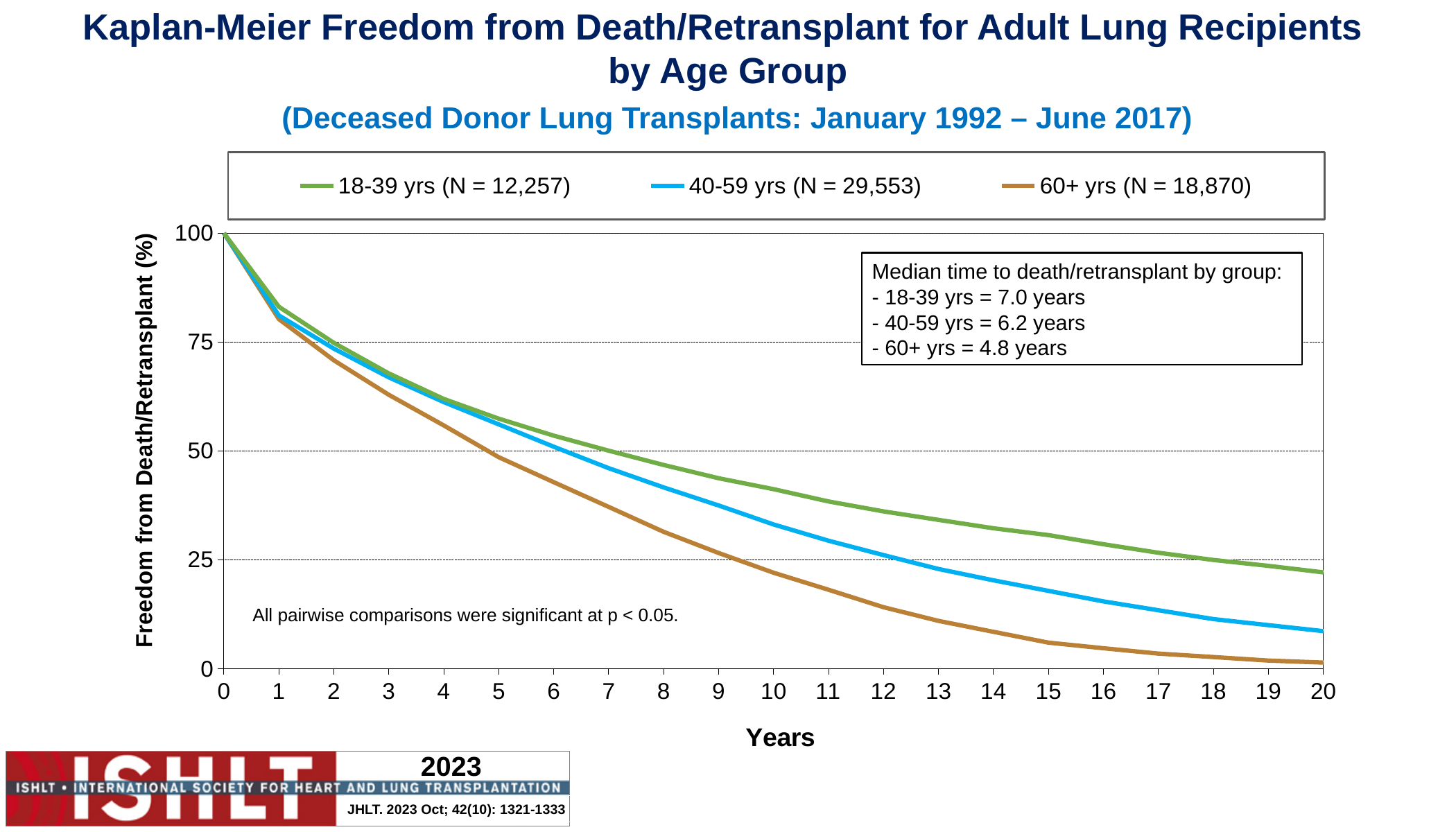
At 5 years, is the freedom from death/retransplant for the 18-39 yrs group greater or less than 50? greater At 10 years, is the freedom from death/retransplant for the 60+ yrs group greater or less than 25? less What is the median time to death/retransplant for the 60+ yrs group? 4.8 years At 15 years, which group has a higher freedom from death/retransplant, 40-59 yrs or 60+ yrs? 40-59 yrs Which age group has the longest median time to death/retransplant? 18-39 yrs How many series does the legend list? 3 What is the difference between the median time to death/retransplant for the 18-39 yrs group and the 60+ yrs group? 2.2 years What is the median time to death/retransplant for the 18-39 yrs group? 7.0 years Which age group has the lowest freedom from death/retransplant at 20 years? 60+ yrs What kind of chart is shown on the slide? line chart What is the N for the 40-59 yrs group shown in the legend? 29,553 Do the curves rise or fall as the number of years increases? fall